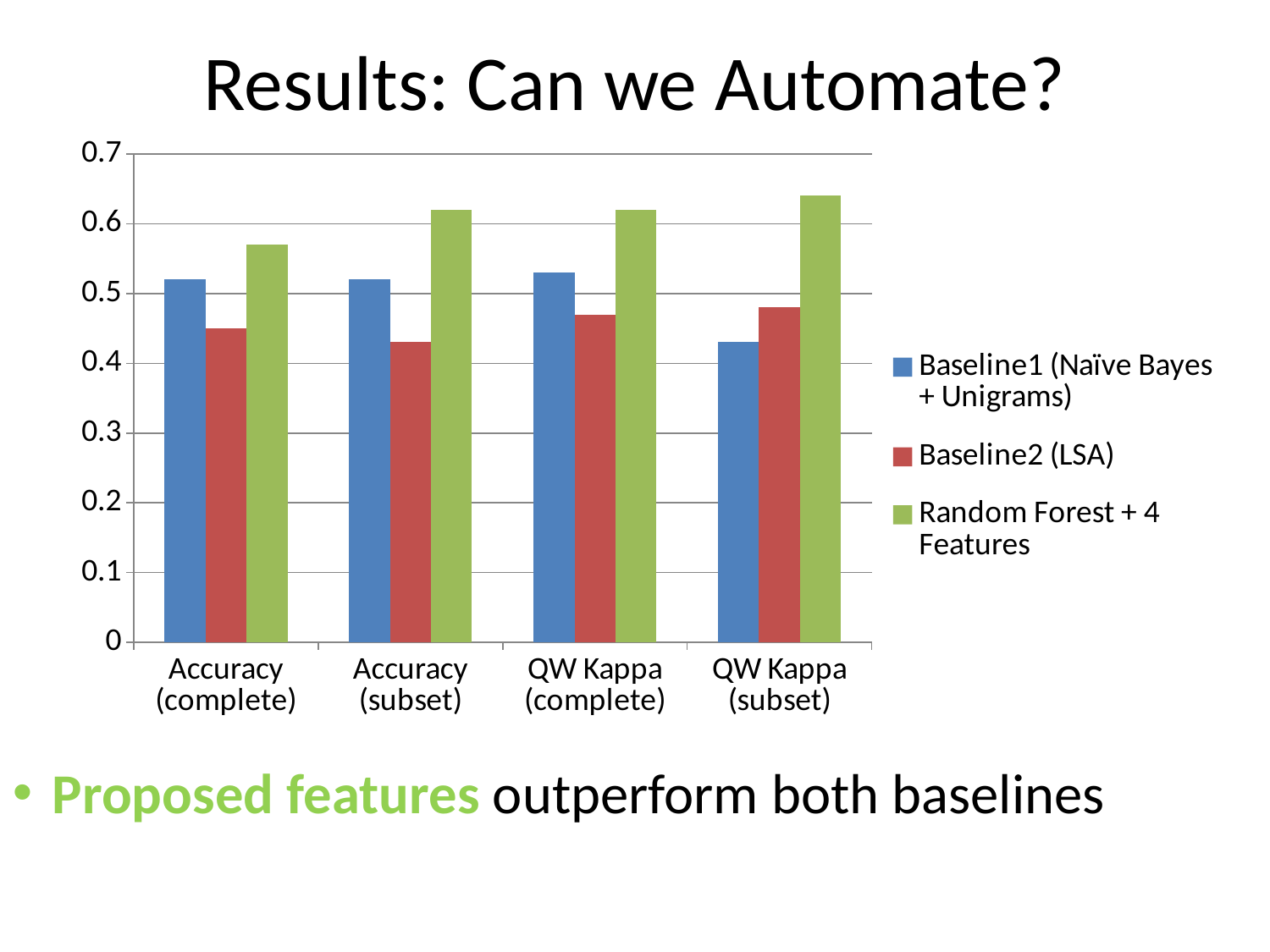
In QW Kappa (subset), which is larger: Baseline1 (Naïve Bayes + Unigrams) or Baseline2 (LSA)? Baseline2 (LSA) Is the value for Baseline2 (LSA) in Accuracy (subset) greater or less than 0.5? less In Accuracy (complete), which is larger: Baseline1 (Naïve Bayes + Unigrams) or Baseline2 (LSA)? Baseline1 (Naïve Bayes + Unigrams) How many series does the chart's legend list? 3 What kind of chart is shown on the slide? bar chart Is the value for Random Forest + 4 Features in QW Kappa (subset) greater or less than 0.6? greater How many categories are shown on the x axis of the chart? 4 Is the value for Random Forest + 4 Features in Accuracy (complete) greater or less than 0.5? greater In which category is the Random Forest + 4 Features bar the tallest? QW Kappa (subset) What colour represents the Random Forest + 4 Features series in the chart? green Which series has the highest bar in every category? Random Forest + 4 Features